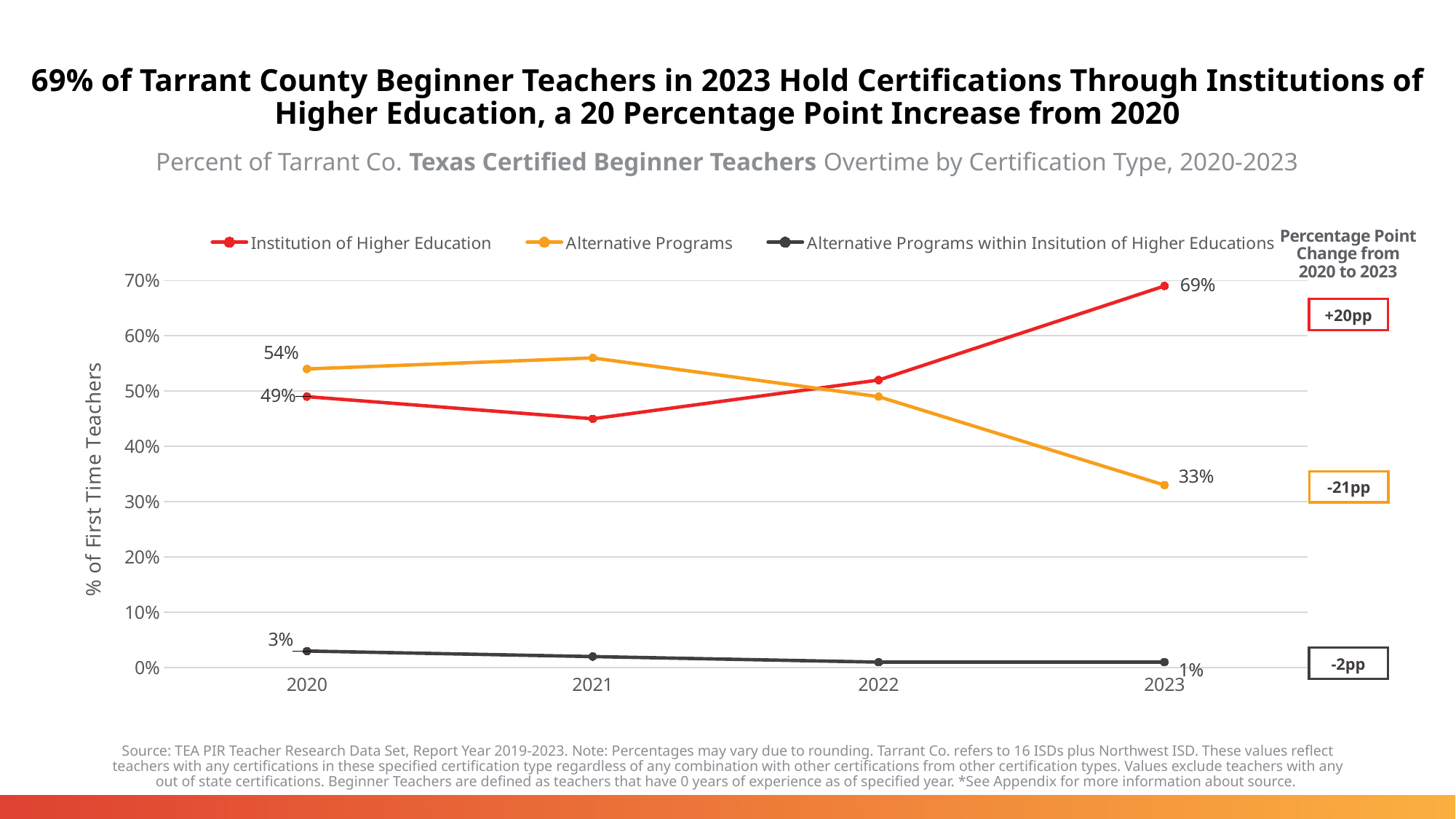
Is the value for Alternative Programs in 2022 greater or less than 40%? greater Does the Alternative Programs line rise or fall from 2021 to 2023? fall Which series has the lowest value in 2020? Alternative Programs within Insitution of Higher Educations What is the value for Institution of Higher Education in 2023? 69% How many series does the legend list? 3 How many years are plotted along the x axis? 4 What kind of chart is shown on the slide? line chart What is the value for Alternative Programs within Institution of Higher Educations in 2023? 1% What is the value for Alternative Programs in 2020? 54% Which series has the highest value in 2023? Institution of Higher Education What is the difference between the Institution of Higher Education value in 2023 and the Alternative Programs value in 2023? 36 percentage points What is the value for Institution of Higher Education in 2020? 49%